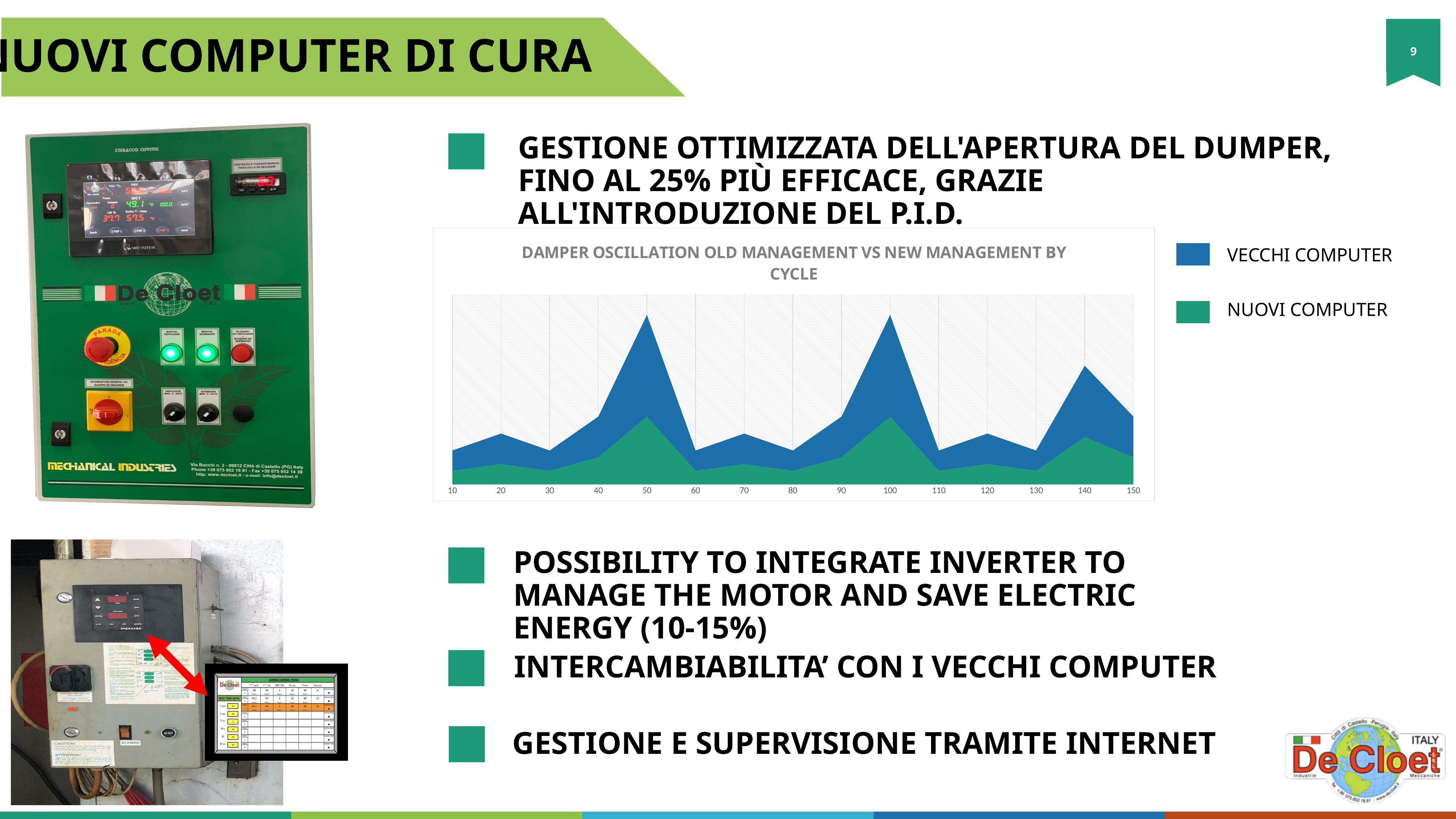
How many cycle values are labelled along the x axis of the chart? 15 Between cycle 100 and cycle 110, does the NUOVI COMPUTER series rise or fall? Fall Between cycle 40 and cycle 50, does the VECCHI COMPUTER series rise or fall? Rise How many series does the chart legend list? 2 At cycle 100, which series has the higher value, VECCHI COMPUTER or NUOVI COMPUTER? VECCHI COMPUTER Which series shows the larger oscillation across the cycles, VECCHI COMPUTER or NUOVI COMPUTER? VECCHI COMPUTER What is the title of the chart? DAMPER OSCILLATION OLD MANAGEMENT VS NEW MANAGEMENT BY CYCLE What are the two series named in the chart legend? VECCHI COMPUTER and NUOVI COMPUTER What is the first cycle value labelled on the x axis of the chart? 10 At cycle 50, which series has the higher value, VECCHI COMPUTER or NUOVI COMPUTER? VECCHI COMPUTER What kind of chart is shown on the slide? Area chart What is the last cycle value labelled on the x axis of the chart? 150